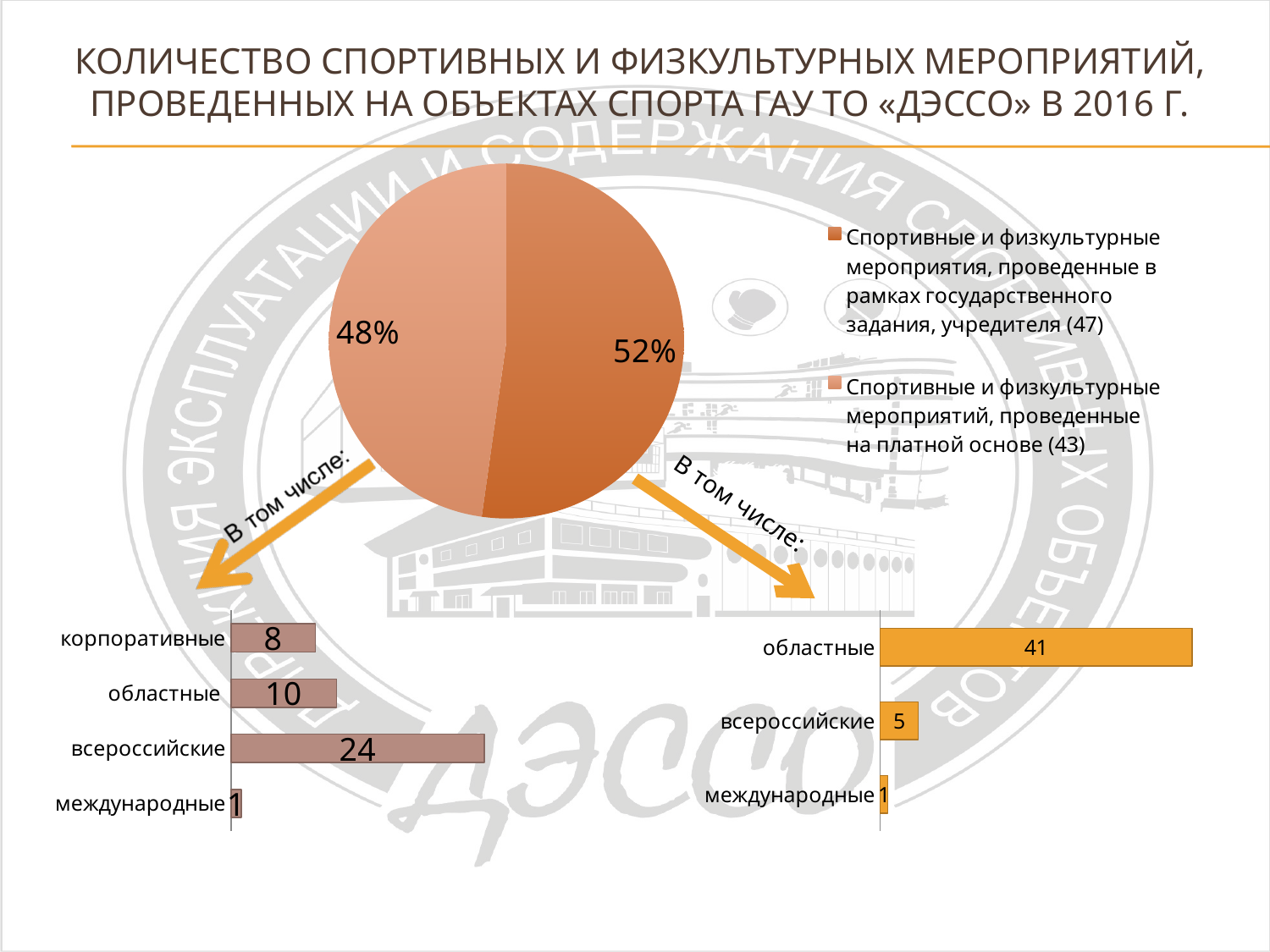
On the bottom-left bar chart, what is the value for 'всероссийские'? 24 How many entries does the legend of the pie chart list? 2 On the bottom-right bar chart, which category has the highest value? областные On the bottom-left bar chart, which category has the lowest value? международные On the bottom-right bar chart, what is the value for 'областные'? 41 What kind of chart is the chart at the top centre of the slide? pie chart On the bottom-right bar chart, which is larger: the value for 'всероссийские' or the value for 'международные'? всероссийские On the pie chart, what share is shown for the slice labelled 'Спортивные и физкультурные мероприятия, проведенные в рамках государственного задания, учредителя (47)'? 52% On the bottom-left bar chart, how many categories are shown? 4 On the bottom-left bar chart, what is the difference between the values for 'всероссийские' and 'областные'? 14 On the bottom-left bar chart, what is the value for 'корпоративные'? 8 On the pie chart, what share is shown for the slice labelled 'Спортивные и физкультурные мероприятий, проведенные на платной основе (43)'? 48%